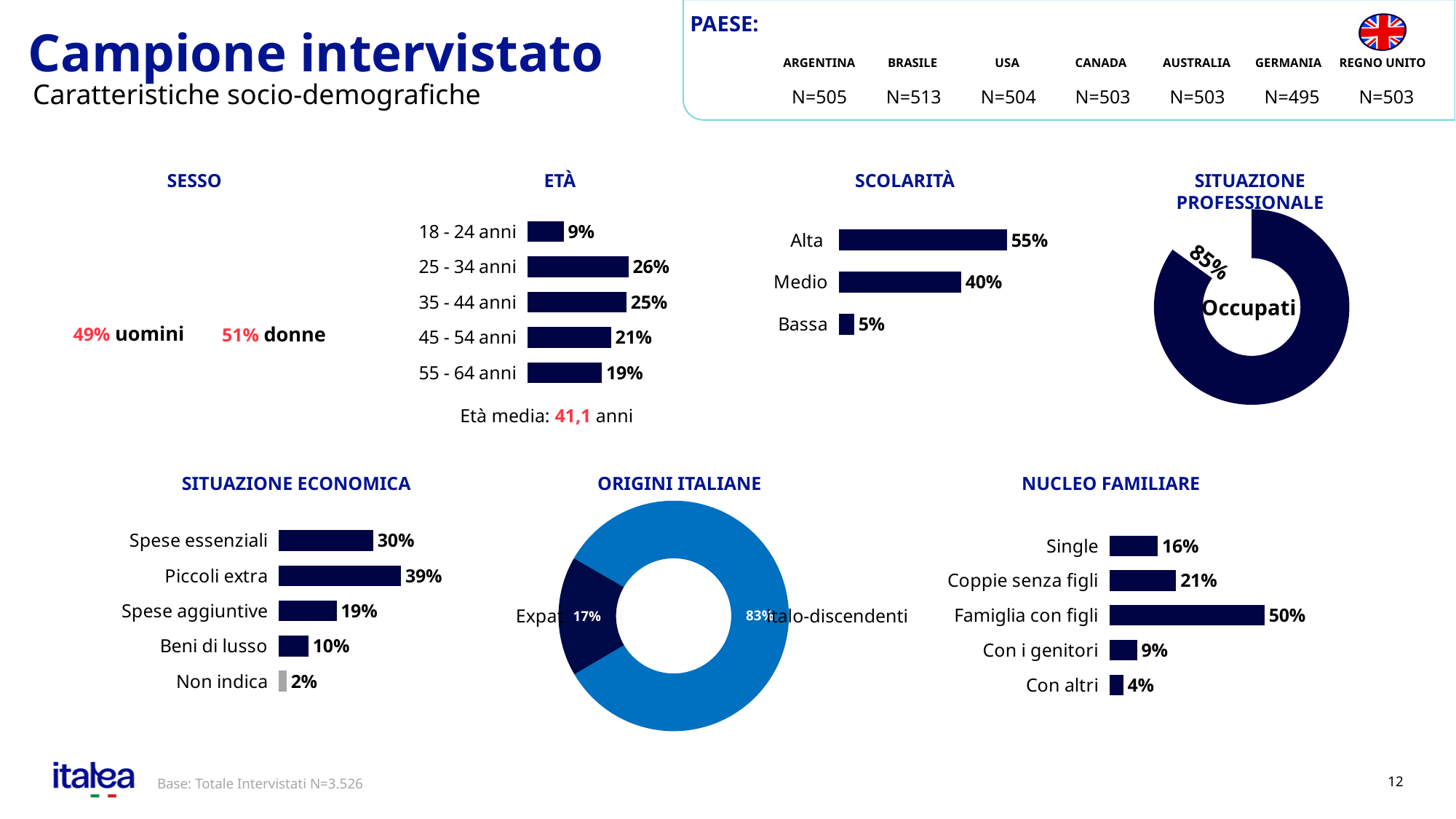
In the SCOLARITÀ chart, what is the difference between Alta and Medio? 15% In the SCOLARITÀ chart, which category has the highest value? Alta In the ETÀ chart, how many age categories are shown? 5 In the ETÀ chart, which age group has the lowest value? 18 - 24 anni In the SITUAZIONE ECONOMICA chart, what is the value for Piccoli extra? 39% In the SITUAZIONE PROFESSIONALE donut chart, what share is labelled Occupati? 85% What kind of chart is the NUCLEO FAMILIARE chart? Bar chart In the ORIGINI ITALIANE donut chart, what share is Expat? 17% In the SITUAZIONE ECONOMICA chart, how many categories are shown? 5 In the ETÀ chart, what is the value for 25 - 34 anni? 26% In the NUCLEO FAMILIARE chart, which category has the highest value? Famiglia con figli In the SITUAZIONE ECONOMICA chart, which is larger, Spese essenziali or Spese aggiuntive? Spese essenziali